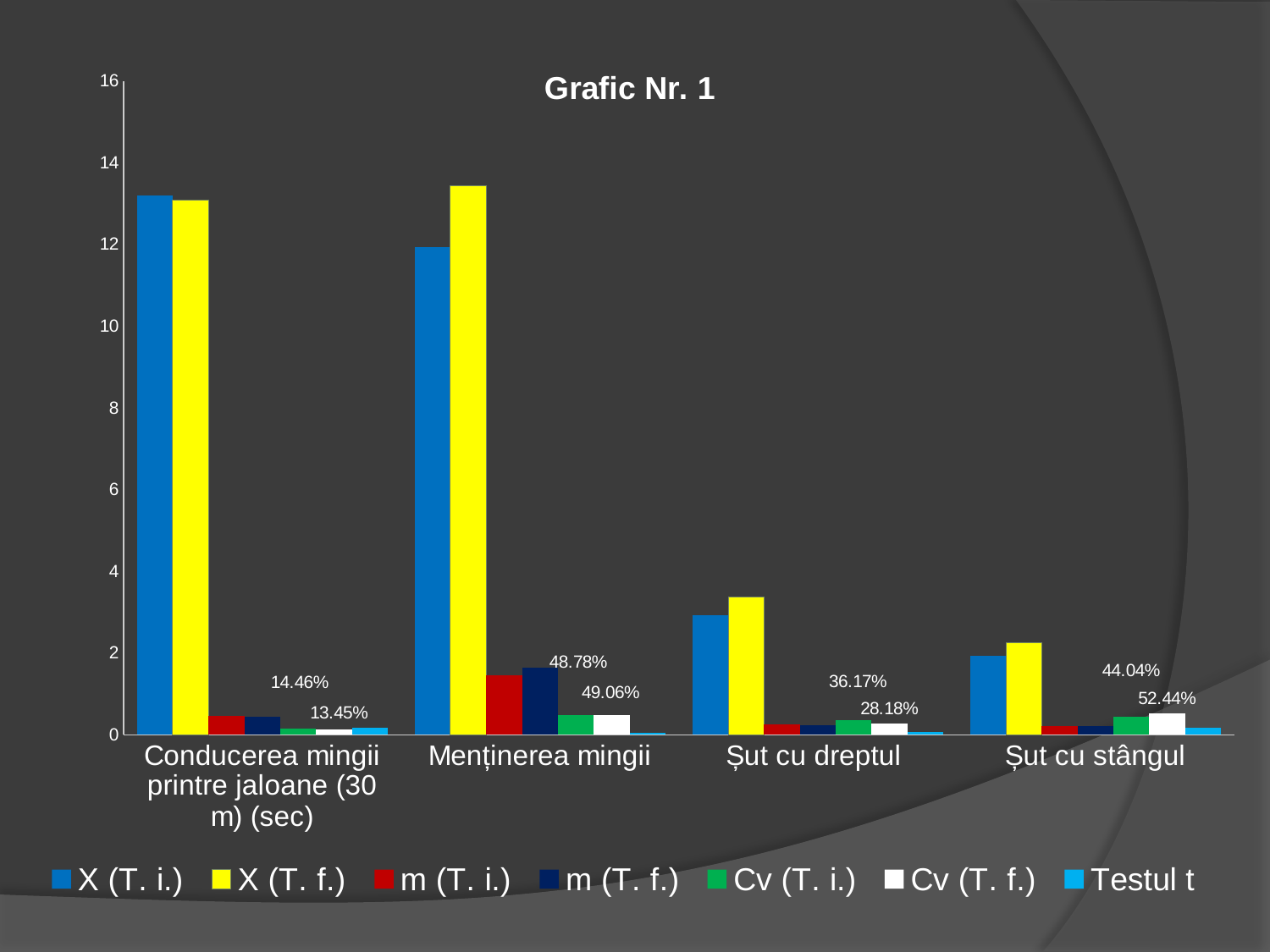
How many series does the legend list? 7 Which category has the lowest Cv (T. i.) value? Conducerea mingii printre jaloane (30 m) (sec) What is the Cv (T. i.) value for Șut cu dreptul? 36.17% How many categories are shown on the x axis? 4 What is the title of the chart? Grafic Nr. 1 For Menținerea mingii, which is larger: X (T. i.) or X (T. f.)? X (T. f.) Is the value of X (T. i.) for Conducerea mingii printre jaloane (30 m) (sec) greater or less than 12? greater Which category has the highest Cv (T. f.) value? Șut cu stângul What is the Cv (T. f.) value for Conducerea mingii printre jaloane (30 m) (sec)? 13.45% What is the difference between the Cv (T. f.) and Cv (T. i.) values for Șut cu stângul? 8.40% What type of chart is shown on the slide? Bar chart What is the Cv (T. f.) value for Menținerea mingii? 49.06%